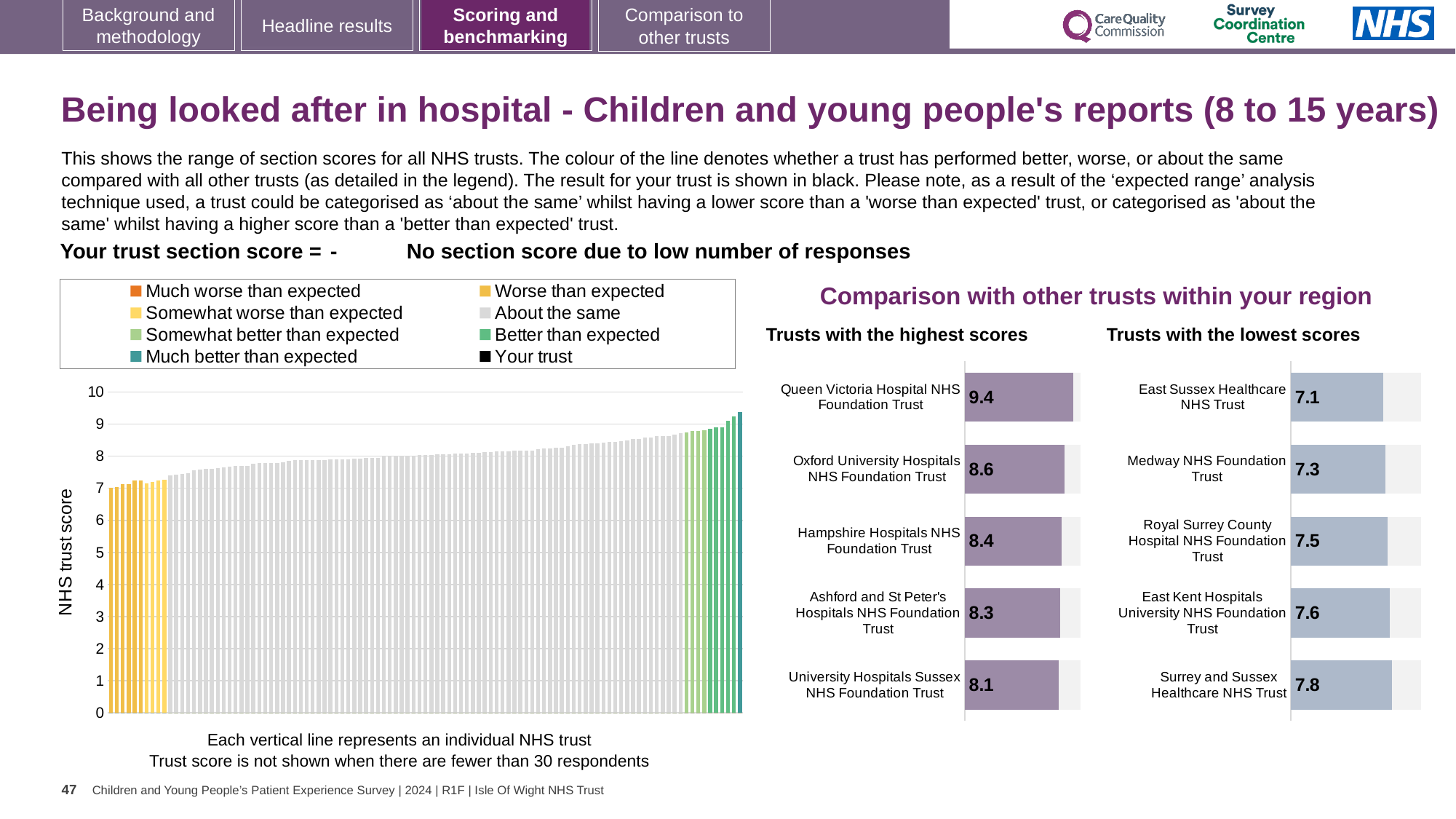
What is the y-axis label of the large chart on the left? NHS trust score What type of chart is the large chart on the left of the slide? bar chart In the 'Trusts with the lowest scores' chart, what is the difference between the scores of Surrey and Sussex Healthcare NHS Trust and East Sussex Healthcare NHS Trust? 0.7 In the 'Trusts with the highest scores' chart, what is the score for Queen Victoria Hospital NHS Foundation Trust? 9.4 In the 'Trusts with the lowest scores' chart, which trust has the highest score shown? Surrey and Sussex Healthcare NHS Trust In the large chart on the left, is the value of the tallest bar greater or less than 9? greater In the 'Trusts with the highest scores' chart, what is the difference between the scores of Queen Victoria Hospital NHS Foundation Trust and Oxford University Hospitals NHS Foundation Trust? 0.8 In the 'Trusts with the highest scores' chart, which trust has the lowest score shown? University Hospitals Sussex NHS Foundation Trust How many trusts are listed in the 'Trusts with the lowest scores' chart? 5 In the large chart on the left, do the bar values rise or fall from left to right? rise In the 'Trusts with the lowest scores' chart, what is the score for Medway NHS Foundation Trust? 7.3 In the 'Trusts with the highest scores' chart, which has a higher score: Hampshire Hospitals NHS Foundation Trust or Ashford and St Peter's Hospitals NHS Foundation Trust? Hampshire Hospitals NHS Foundation Trust